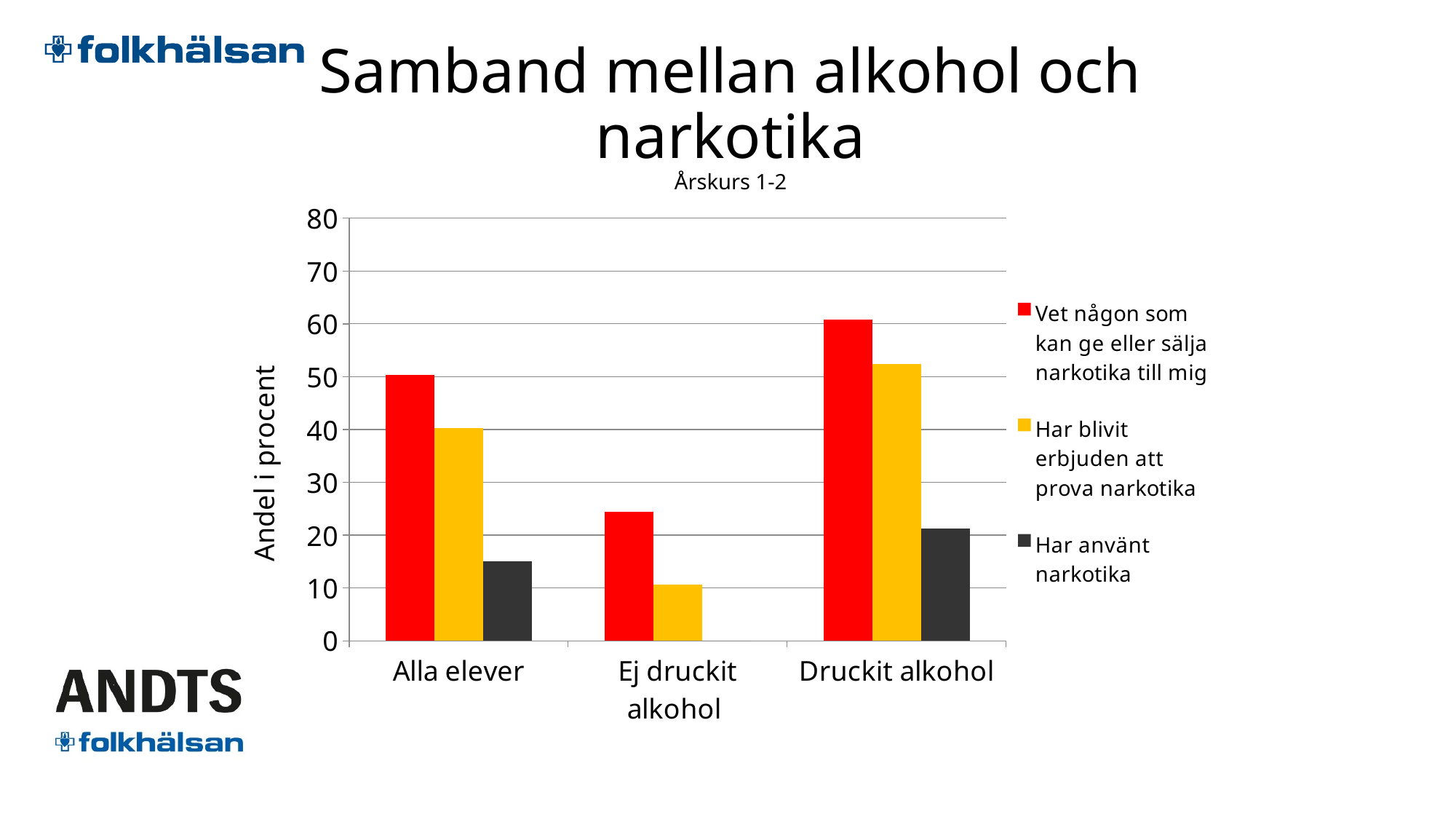
How many series does the chart's legend list? 3 Which category has the lowest value for 'Har blivit erbjuden att prova narkotika'? Ej druckit alkohol Is the value for 'Har använt narkotika' in the 'Alla elever' category greater or less than 10? greater Is the value for 'Har använt narkotika' in the 'Druckit alkohol' category greater or less than 30? less What is the label of the chart's y axis? Andel i procent Is the value for 'Vet någon som kan ge eller sälja narkotika till mig' in the 'Ej druckit alkohol' category greater or less than 30? less Which category has the highest value for 'Vet någon som kan ge eller sälja narkotika till mig'? Druckit alkohol How many categories are shown on the x axis of the chart? 3 What colour are the bars for the series 'Har använt narkotika'? dark grey What kind of chart is shown on the slide? bar chart Is the value for 'Vet någon som kan ge eller sälja narkotika till mig' larger for 'Druckit alkohol' or for 'Alla elever'? Druckit alkohol